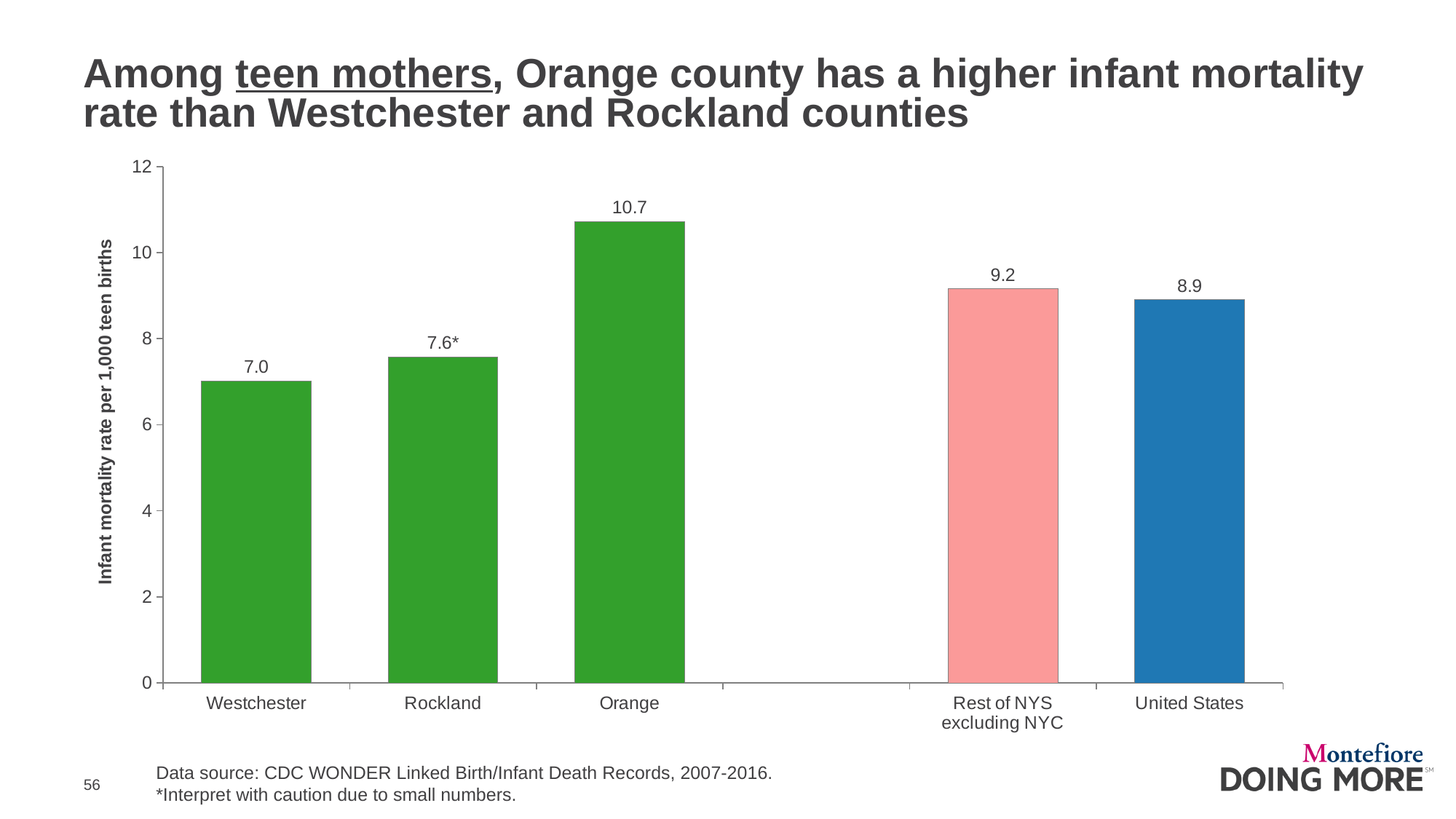
How many categories are plotted on the chart? 5 What is the infant mortality rate per 1,000 teen births for Orange county? 10.7 Is the value for Rockland greater or less than 8? less Which is larger, the rate for Rest of NYS excluding NYC or the rate for the United States? Rest of NYS excluding NYC What value is shown for the United States? 8.9 Which category has the lowest infant mortality rate among teen mothers? Westchester What value is shown for Rest of NYS excluding NYC? 9.2 Which category's data label is marked with an asterisk? Rockland What is the difference between the infant mortality rates for Orange and Westchester? 3.7 What kind of chart is shown on the slide? Bar chart Which category has the highest infant mortality rate among teen mothers? Orange What is the infant mortality rate per 1,000 teen births for Westchester? 7.0